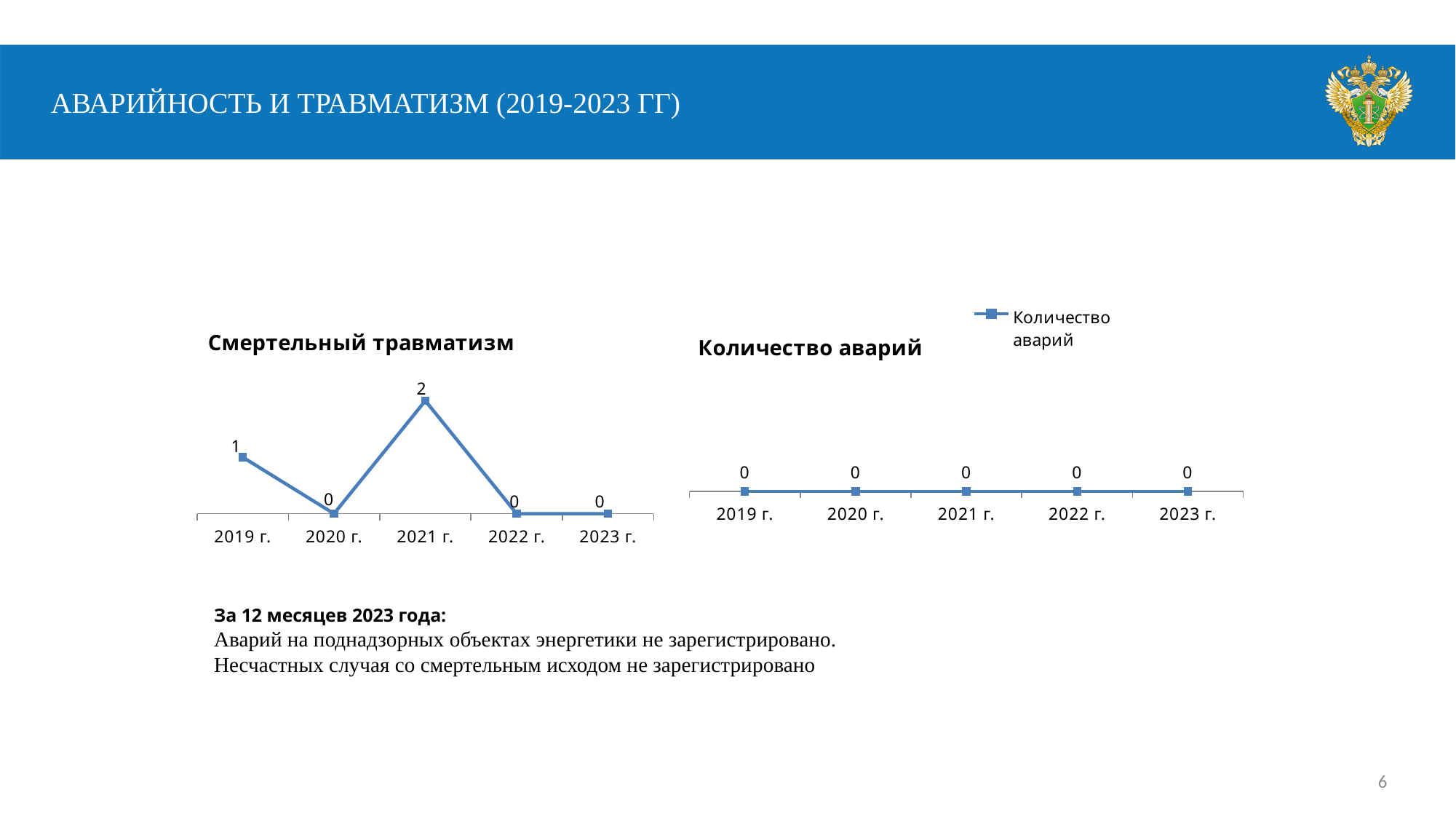
In the 'Смертельный травматизм' chart, which year has the highest value? 2021 г. In the 'Количество аварий' chart, what is the value for 2022 г.? 0 What is the legend entry in the 'Количество аварий' chart? Количество аварий In the 'Смертельный травматизм' chart, what is the value for 2023 г.? 0 In the 'Смертельный травматизм' chart, what is the difference between the values for 2021 г. and 2019 г.? 1 How many series does the legend of the 'Количество аварий' chart list? 1 In the 'Количество аварий' chart, how do the values change from 2019 г. to 2023 г.? They stay flat at 0 How many data points are plotted in the 'Смертельный травматизм' chart? 5 What kind of chart is the 'Смертельный травматизм' chart? line chart In the 'Смертельный травматизм' chart, which is larger, the value for 2019 г. or the value for 2020 г.? 2019 г. In the 'Смертельный травматизм' chart, what is the value for 2019 г.? 1 In the 'Смертельный травматизм' chart, what is the value for 2021 г.? 2